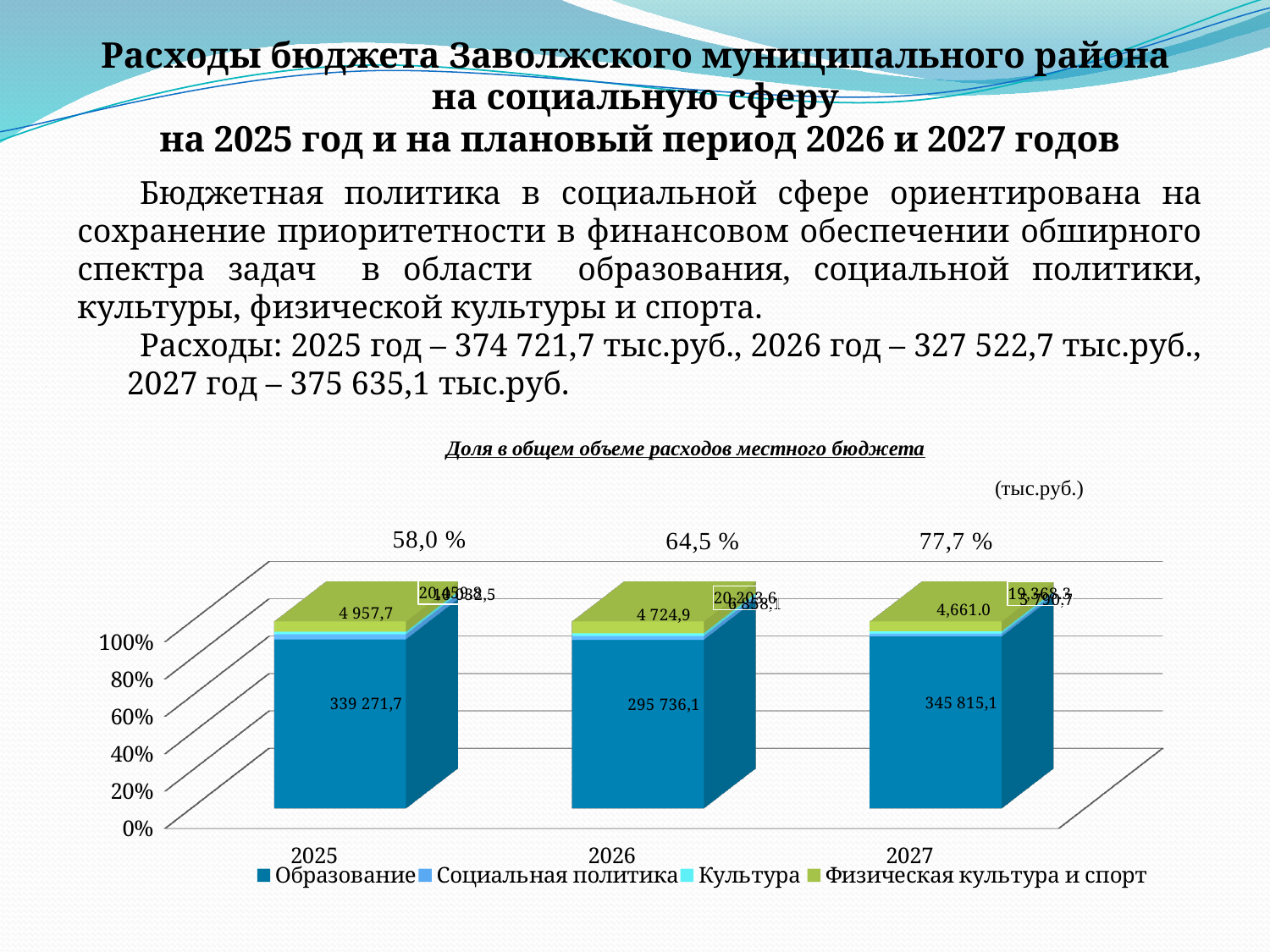
What is the title of the chart? Доля в общем объеме расходов местного бюджета In which year is the value for Образование the lowest? 2026 What is the value for Образование in 2026? 295 736,1 How many years (categories) are shown on the x axis of the chart? 3 What kind of chart is shown on the slide? Stacked bar chart What is the value for Образование in 2025? 339 271,7 Which is larger, the Образование value for 2025 or for 2026? 2025 What percentage is printed above the 2027 bar? 77,7 % What is the value for Образование in 2027? 345 815,1 How many series does the chart legend list? 4 What is the difference between the Образование values for 2027 and 2025? 6 543,4 In which year is the value for Образование the highest? 2027